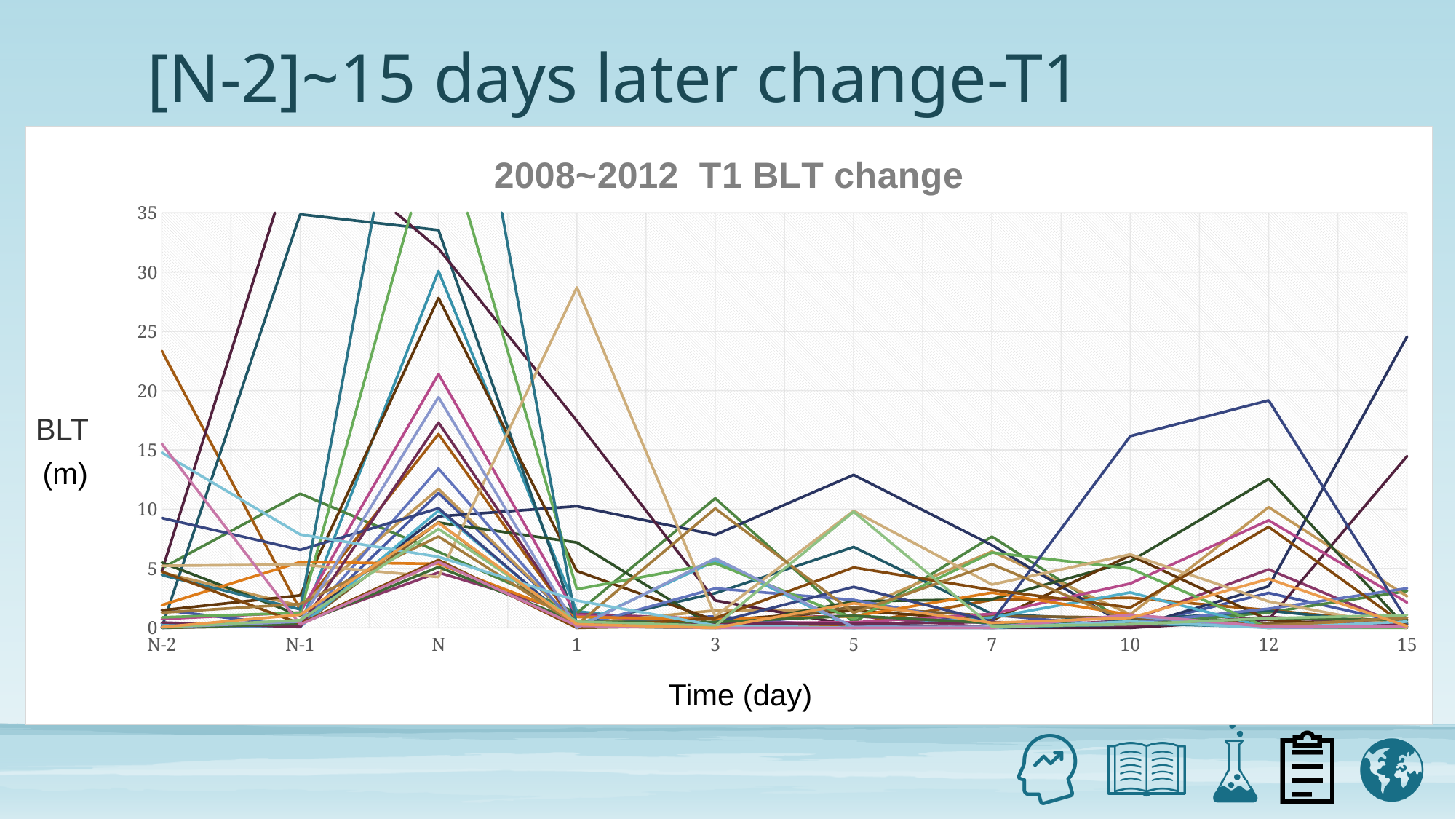
What is the label of the x axis? Time (day) What is the first category label on the x axis? N-2 What is the highest tick value shown on the y axis? 35 What is the last category label on the x axis? 15 Does the chart include a legend identifying the series? No What kind of chart is shown on the slide? line chart How many time points are labelled along the x axis of the chart? 10 What is the title of the chart? 2008~2012 T1 BLT change